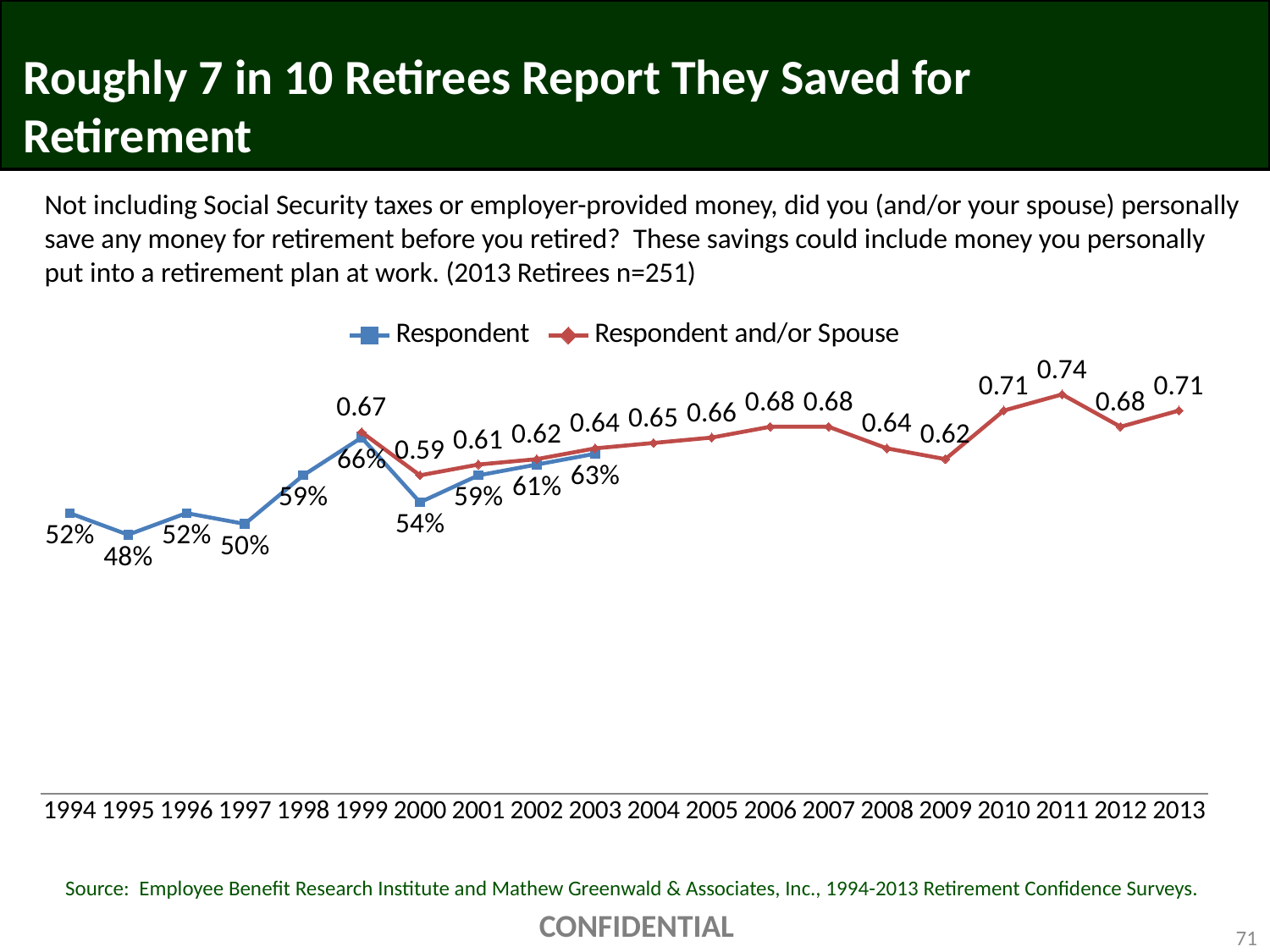
How many years are shown on the x axis? 20 What kind of chart is shown on the slide? Line chart Does the Respondent and/or Spouse series rise or fall from 2007 to 2009? Fall What is the difference between the Respondent and/or Spouse values for 2011 and 2012? 0.06 In which year does the Respondent series have its lowest value? 1995 What is the value for Respondent and/or Spouse in 2011? 0.74 What is the value for Respondent and/or Spouse in 2013? 0.71 What is the value for Respondent in 1995? 48% How many series does the legend list? 2 In 2000, which series has the larger value, Respondent or Respondent and/or Spouse? Respondent and/or Spouse In which year does the Respondent and/or Spouse series reach its highest value? 2011 By how many percentage points did the Respondent value drop from 1999 to 2000? 12 percentage points